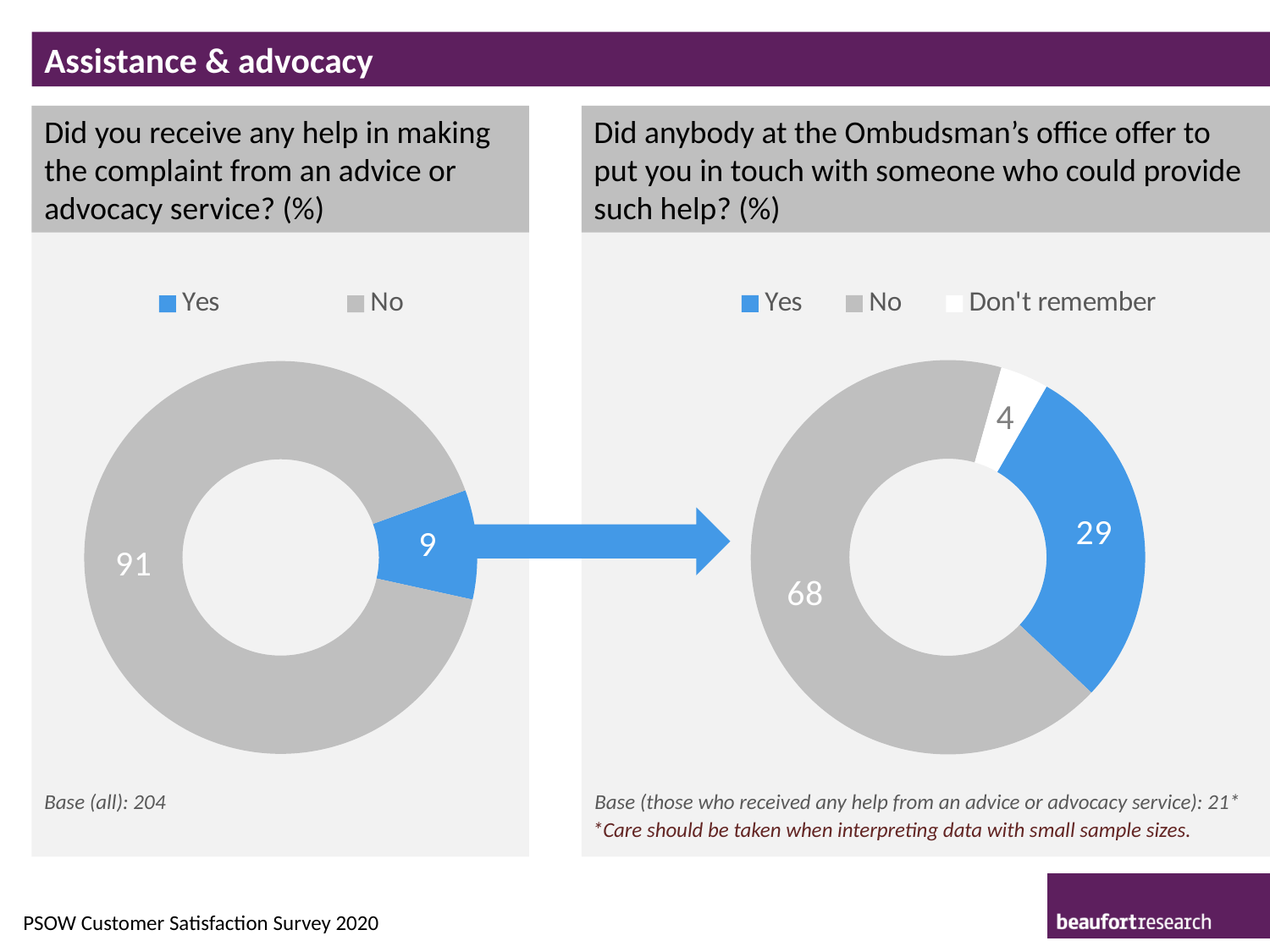
In the right chart ("Did anybody at the Ombudsman's office offer to put you in touch with someone who could provide such help?"), what is the value for Yes? 29 In the right chart ("Did anybody at the Ombudsman's office offer to put you in touch with someone who could provide such help?"), what is the value for Don't remember? 4 In the right chart ("Did anybody at the Ombudsman's office offer to put you in touch with someone who could provide such help?"), what is the difference between the No and Yes values? 39 What type of chart is used on the left side of the slide? Donut (pie) chart In the left chart ("Did you receive any help in making the complaint from an advice or advocacy service?"), what is the value for No? 91 In the right chart ("Did anybody at the Ombudsman's office offer to put you in touch with someone who could provide such help?"), which category has the smallest share? Don't remember In the right chart ("Did anybody at the Ombudsman's office offer to put you in touch with someone who could provide such help?"), which category has the largest share? No In the left chart ("Did you receive any help in making the complaint from an advice or advocacy service?"), what is the difference between the No and Yes values? 82 In the left chart ("Did you receive any help in making the complaint from an advice or advocacy service?"), what is the value for Yes? 9 What colour represents the Yes category in both charts? Blue How many categories does the legend of the right chart ("Did anybody at the Ombudsman's office offer to put you in touch with someone who could provide such help?") list? 3 Which is larger: the Yes value in the left chart or the Yes value in the right chart? The Yes value in the right chart